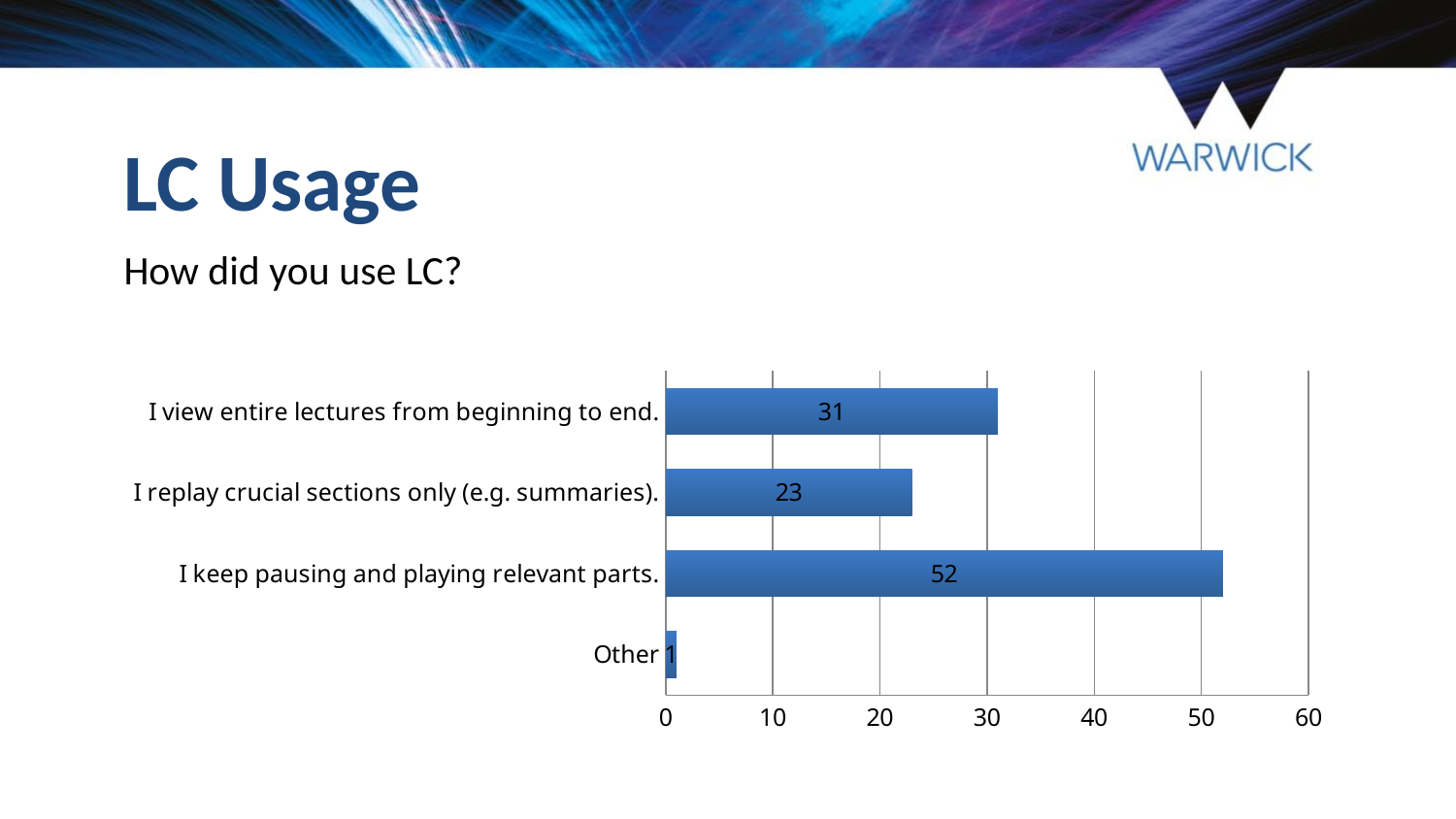
Which category has the lowest value? Other Which is larger: the value for "I view entire lectures from beginning to end." or "I replay crucial sections only (e.g. summaries)."? I view entire lectures from beginning to end. What kind of chart is shown on the slide? bar chart How many categories are shown in the chart? 4 What is the value for "Other"? 1 What is the value for "I keep pausing and playing relevant parts."? 52 Which category has the highest value? I keep pausing and playing relevant parts. Is the value for "I keep pausing and playing relevant parts." greater or less than 40? greater What is the difference between the values for "I keep pausing and playing relevant parts." and "I view entire lectures from beginning to end."? 21 What is the value for "I view entire lectures from beginning to end."? 31 What is the value for "I replay crucial sections only (e.g. summaries)."? 23 What is the maximum value shown on the horizontal axis? 60